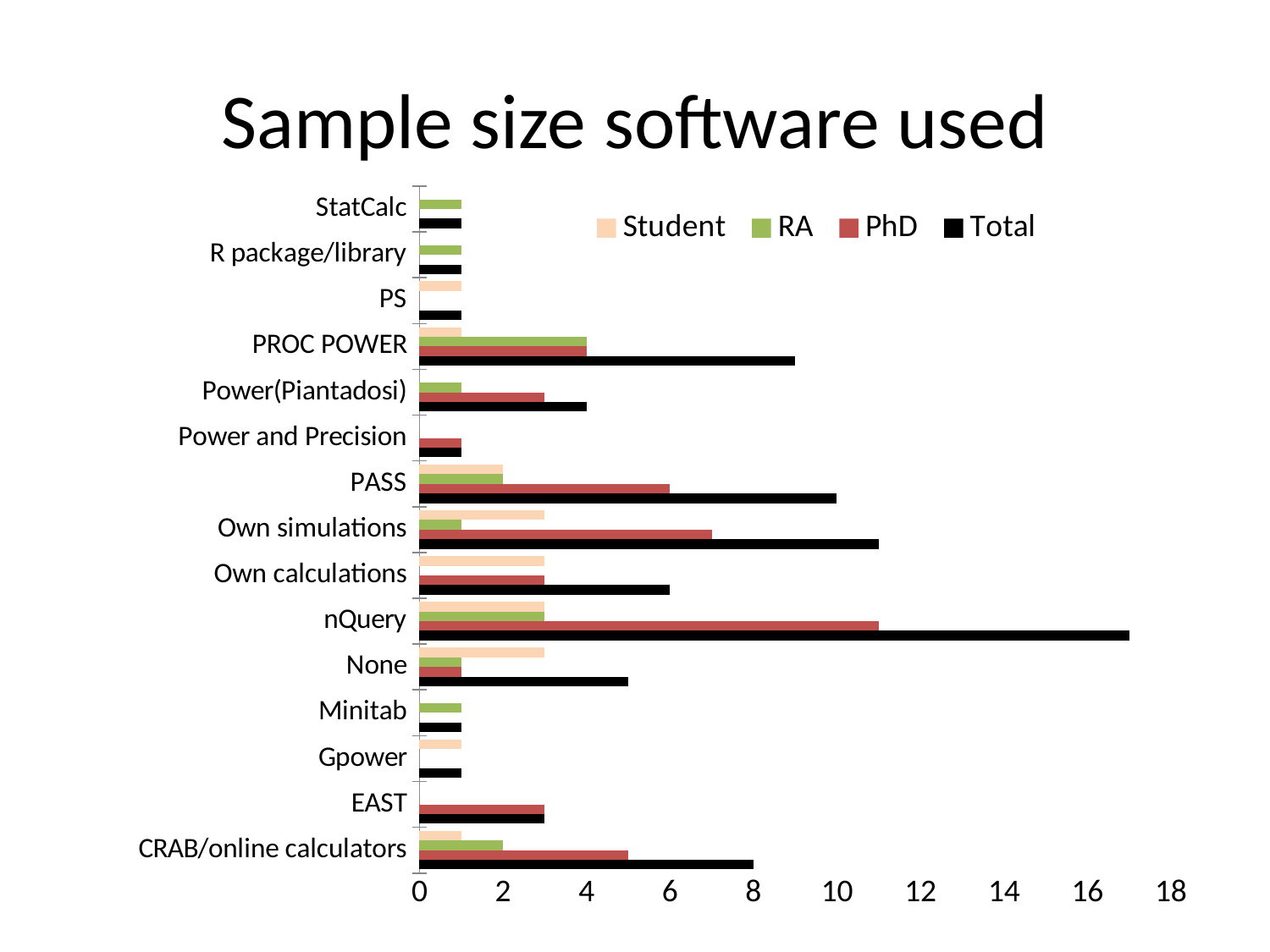
What is the RA value for PROC POWER? 4 Is the Total value for Own simulations greater or less than 10? greater What is the difference between the Total value for PASS and the Total value for CRAB/online calculators? 2 What is the Total value for PASS? 10 What type of chart is shown on the slide? bar chart What is the Total value for CRAB/online calculators? 8 What is the title of the chart? Sample size software used Which category has the highest Total value? nQuery How many software categories are shown on the chart? 15 How many series does the legend list? 4 Which is larger, the Total value for nQuery or the Total value for PASS? nQuery Is the Total value for nQuery greater or less than 16? greater